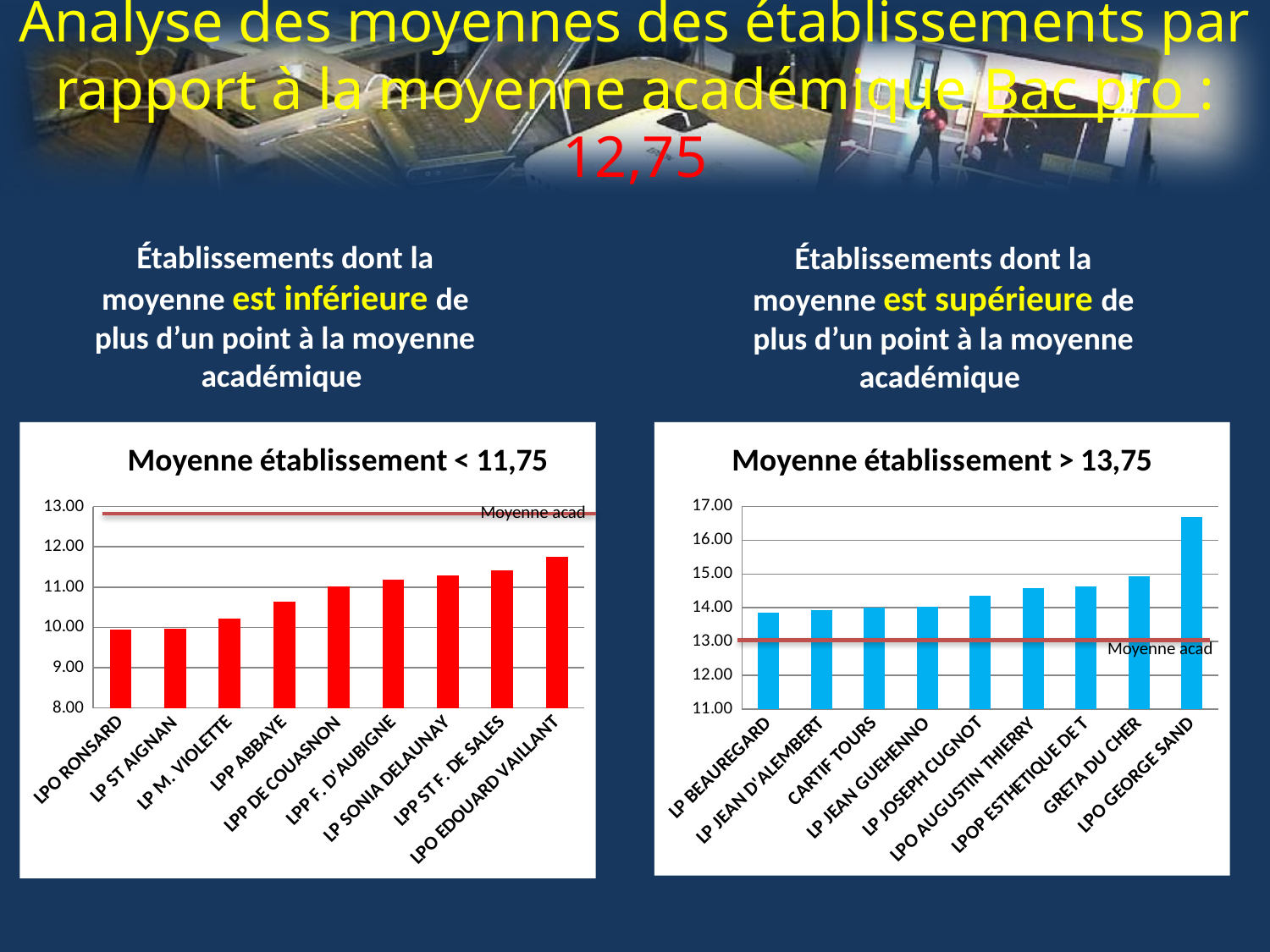
How many establishments are shown in the left chart "Moyenne établissement < 11,75"? 9 In the right chart "Moyenne établissement > 13,75", is the value for LPO GEORGE SAND greater or less than 16.00? greater In the left chart "Moyenne établissement < 11,75", is the value for LPP ABBAYE greater or less than 10.00? greater How many establishments are shown in the right chart "Moyenne établissement > 13,75"? 9 In the right chart "Moyenne établissement > 13,75", which establishment has the highest value? LPO GEORGE SAND What type of chart is the left chart titled "Moyenne établissement < 11,75"? bar chart In the left chart "Moyenne établissement < 11,75", which establishment has the highest value? LPO EDOUARD VAILLANT In the right chart "Moyenne établissement > 13,75", which is larger, the value for LPO AUGUSTIN THIERRY or the value for LP BEAUREGARD? LPO AUGUSTIN THIERRY In the left chart "Moyenne établissement < 11,75", is the value for LP SONIA DELAUNAY greater or less than 11.00? greater In the left chart "Moyenne établissement < 11,75", do the values rise or fall from left to right? rise In the left chart "Moyenne établissement < 11,75", what does the red horizontal line represent? Moyenne acad